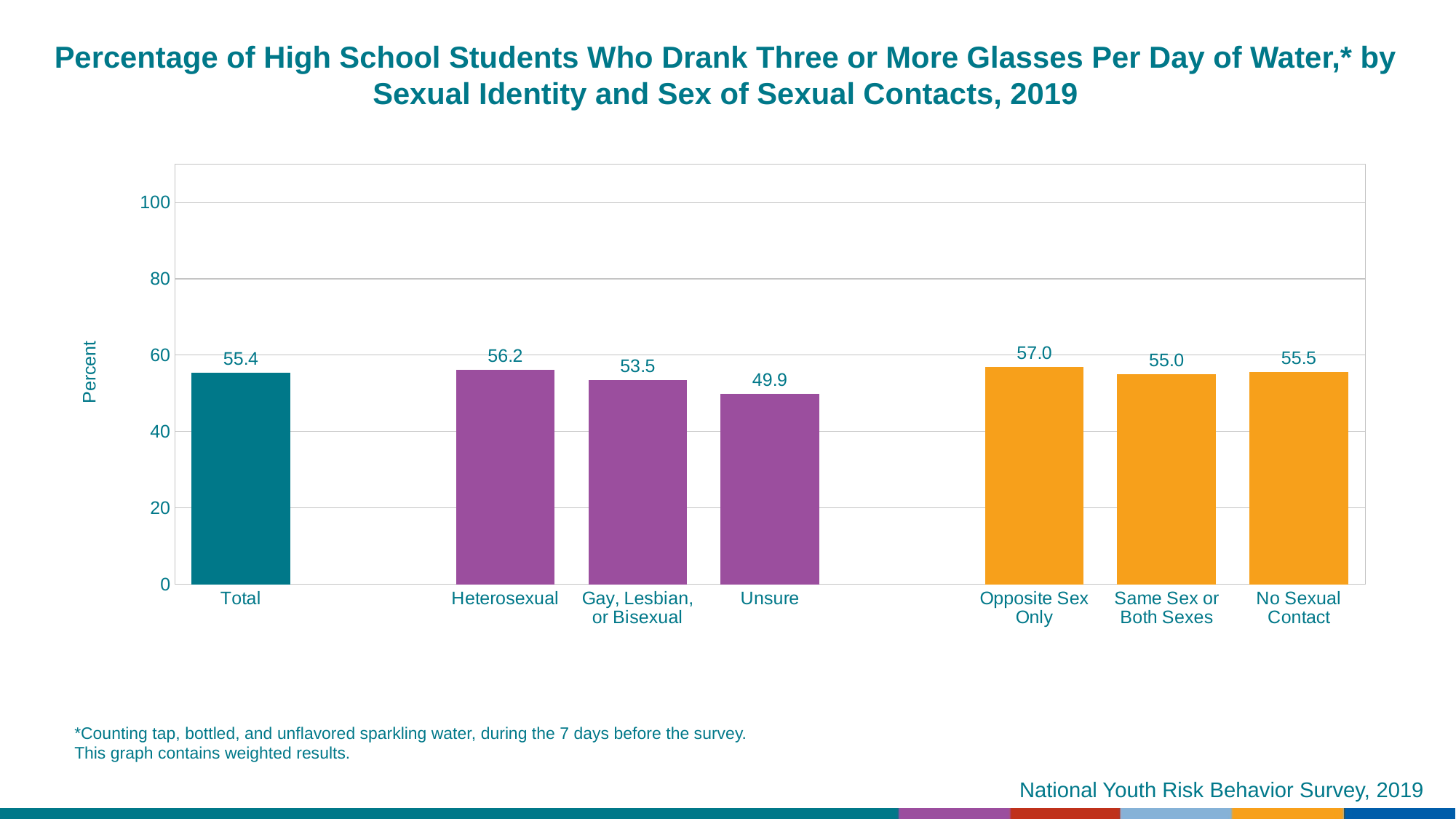
What is the value for Gay, Lesbian, or Bisexual? 53.5 How many categories are shown in the chart? 7 What is the label of the y axis? Percent What is the difference between the values for Opposite Sex Only and Same Sex or Both Sexes? 2.0 What kind of chart is shown on the slide? Bar chart Which is larger, the value for Heterosexual or the value for Gay, Lesbian, or Bisexual? Heterosexual What is the value for Total? 55.4 What is the value for Unsure? 49.9 Which category has the highest value? Opposite Sex Only What is the difference between the values for Heterosexual and Unsure? 6.3 Which category has the lowest value? Unsure What is the value for Opposite Sex Only? 57.0